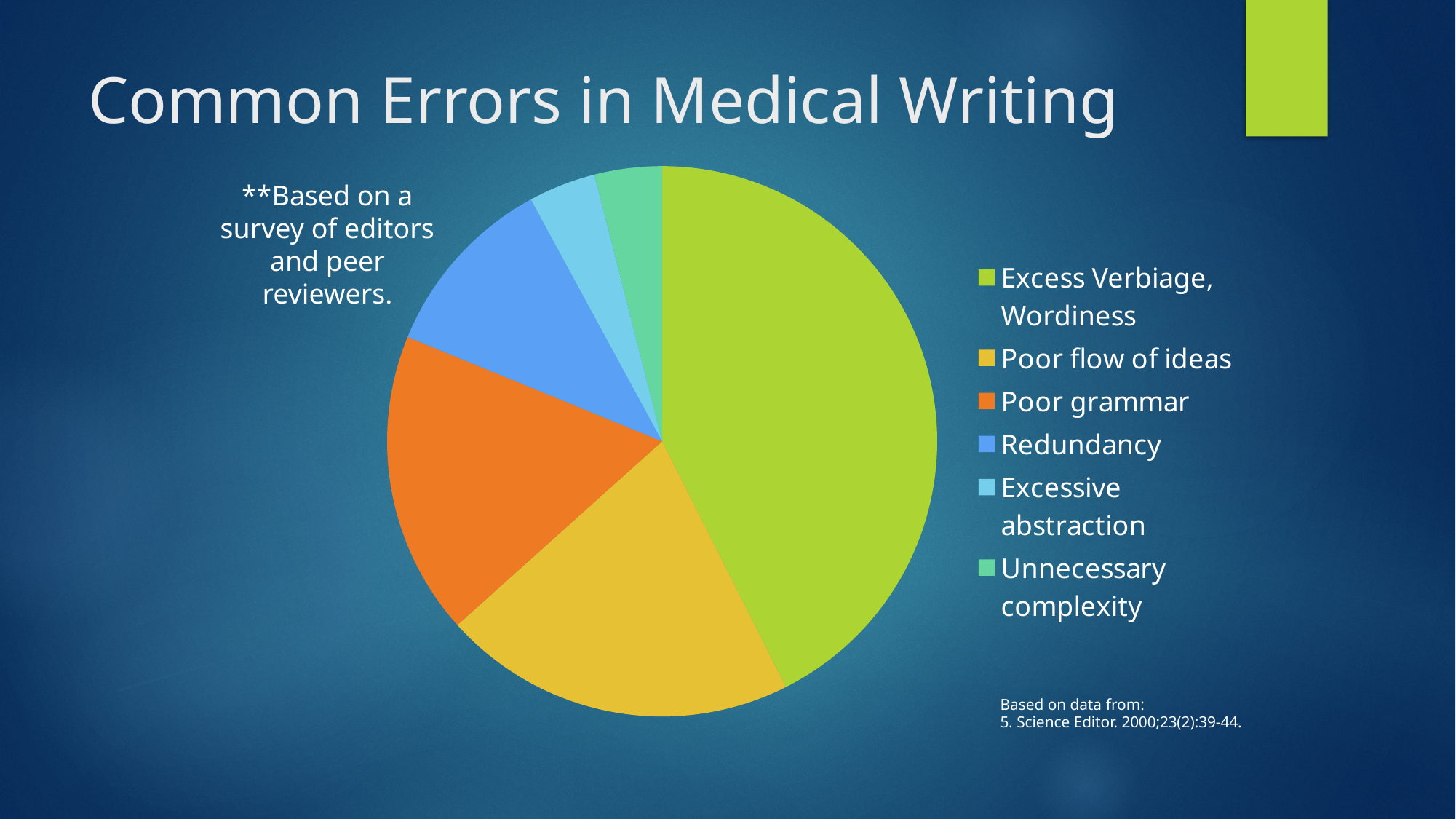
How many categories does the pie chart show? 6 Which is larger in the pie chart: Excess Verbiage, Wordiness or Poor flow of ideas? Excess Verbiage, Wordiness What is the title of the slide containing the pie chart? Common Errors in Medical Writing Which is larger in the pie chart: Redundancy or Unnecessary complexity? Redundancy Which is larger in the pie chart: Poor flow of ideas or Poor grammar? Poor flow of ideas Does the Excess Verbiage, Wordiness slice take up more or less than half of the pie? less What kind of chart is shown on the slide? pie chart What colour is the Poor grammar slice in the pie chart? orange Which category has the largest slice of the pie chart? Excess Verbiage, Wordiness